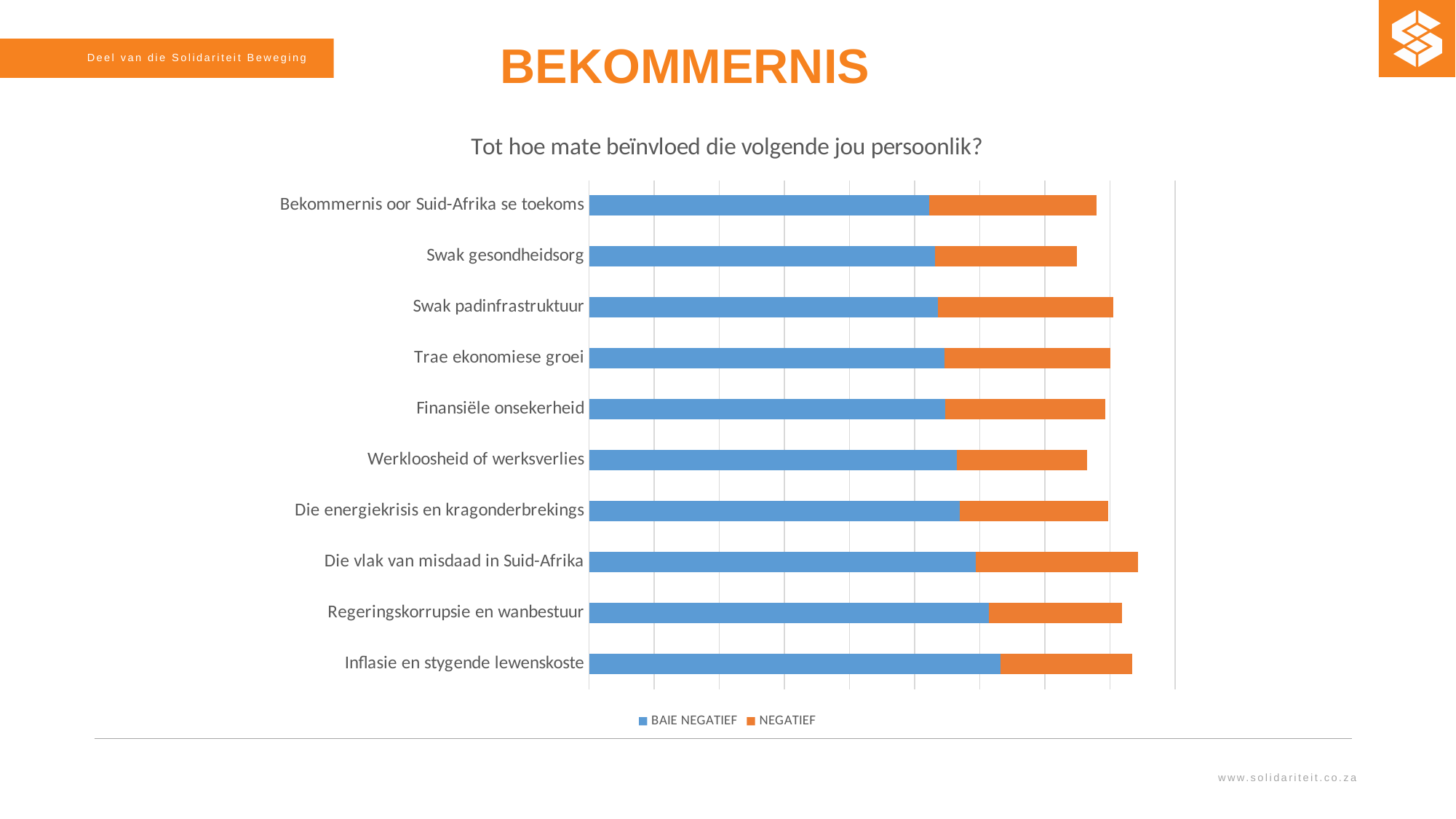
Which has the longer BAIE NEGATIEF segment: Inflasie en stygende lewenskoste or Bekommernis oor Suid-Afrika se toekoms? Inflasie en stygende lewenskoste How many categories are plotted on the chart? 10 For Inflasie en stygende lewenskoste, which segment is larger: BAIE NEGATIEF or NEGATIEF? BAIE NEGATIEF What is the title of the chart? Tot hoe mate beïnvloed die volgende jou persoonlik? Which has the longer total bar: Werkloosheid of werksverlies or Inflasie en stygende lewenskoste? Inflasie en stygende lewenskoste Which series is shown in orange? NEGATIEF How many series does the legend list? 2 What kind of chart is shown on the slide? Stacked bar chart Which category is listed at the top of the chart? Bekommernis oor Suid-Afrika se toekoms